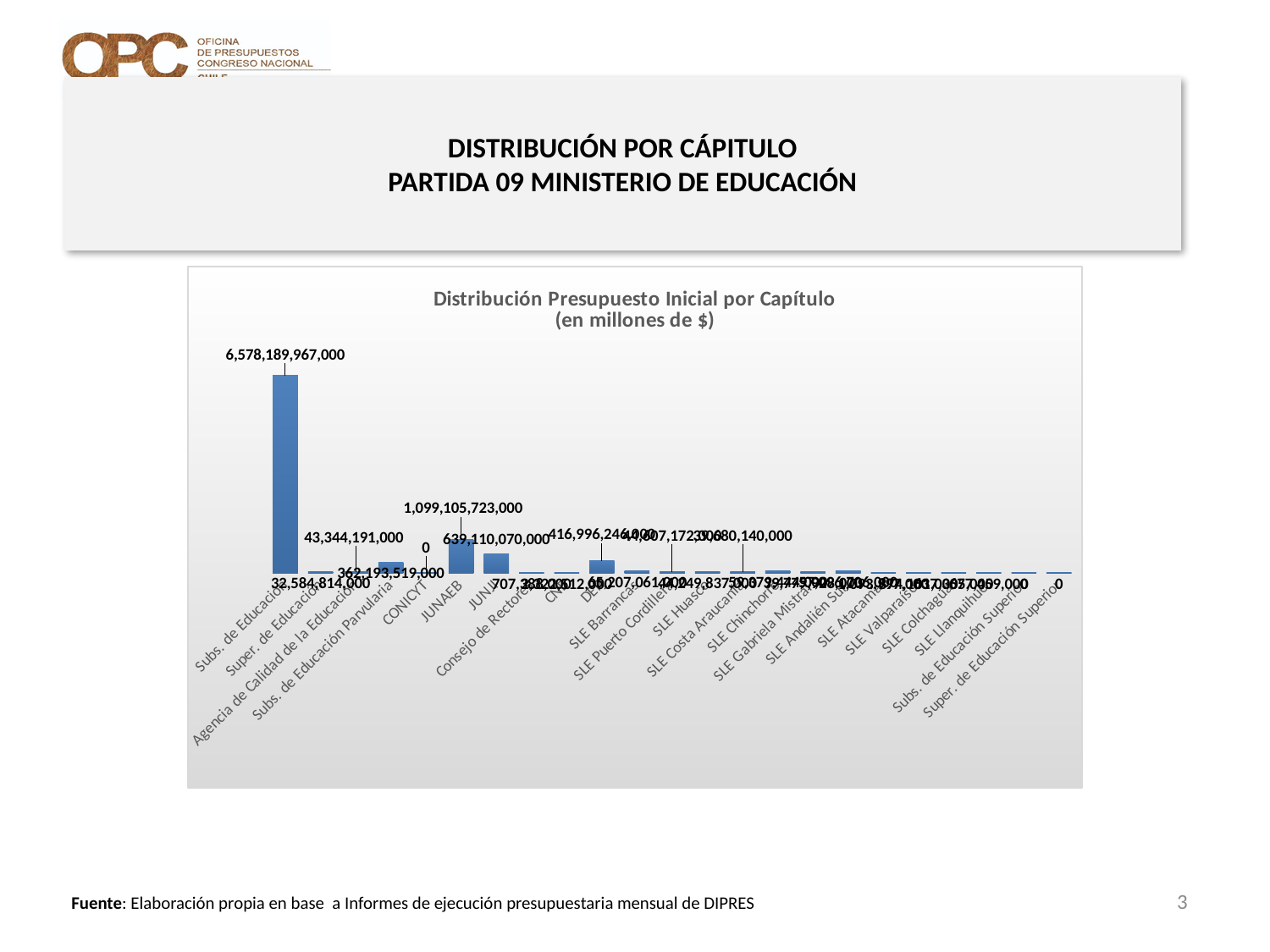
What is the value shown for JUNJI? 639,110,070,000 Which is larger, the value for Subs. de Educación Parvularia or the value for JUNJI? JUNJI What is the value shown for Subs. de Educación Parvularia? 362,193,519,000 What is the value shown for Super. de Educación Superior? 0 What is the title of the chart? Distribución Presupuesto Inicial por Capítulo (en millones de $) What is the value shown for CONICYT? 0 Which capítulo has the highest value in the chart? Subs. de Educación What is the difference between the values for JUNAEB and JUNJI? 459,995,653,000 What is the value shown for Subs. de Educación? 6,578,189,967,000 Which is larger, the value for JUNAEB or the value for JUNJI? JUNAEB What is the value shown for JUNAEB? 1,099,105,723,000 What kind of chart is shown on the slide? Bar chart